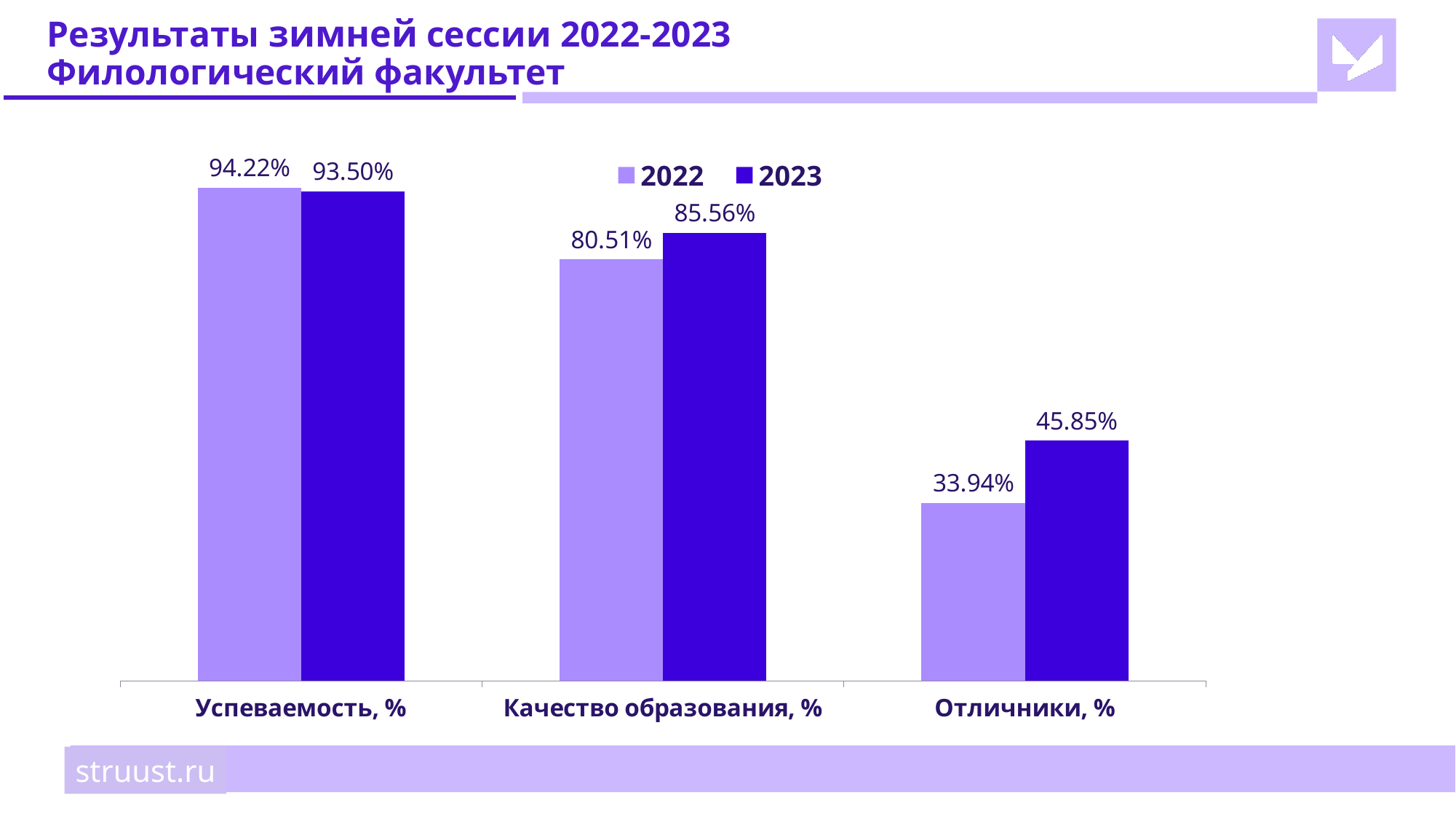
What kind of chart is shown on the slide? Bar chart Which is larger for Качество образования, %: the 2022 value or the 2023 value? 2023 Which category has the highest value in the 2022 series? Успеваемость, % What are the two series named in the legend? 2022 and 2023 What is the difference between the 2023 and 2022 values for Отличники, %? 11.91% How many categories are shown on the x axis? 3 Which category has the lowest value in the 2023 series? Отличники, % What is the value for Успеваемость, % in 2022? 94.22% What is the value for Отличники, % in 2023? 45.85% How many series does the legend list? 2 What is the value for Качество образования, % in 2022? 80.51% What is the difference between the 2023 and 2022 values for Качество образования, %? 5.05%